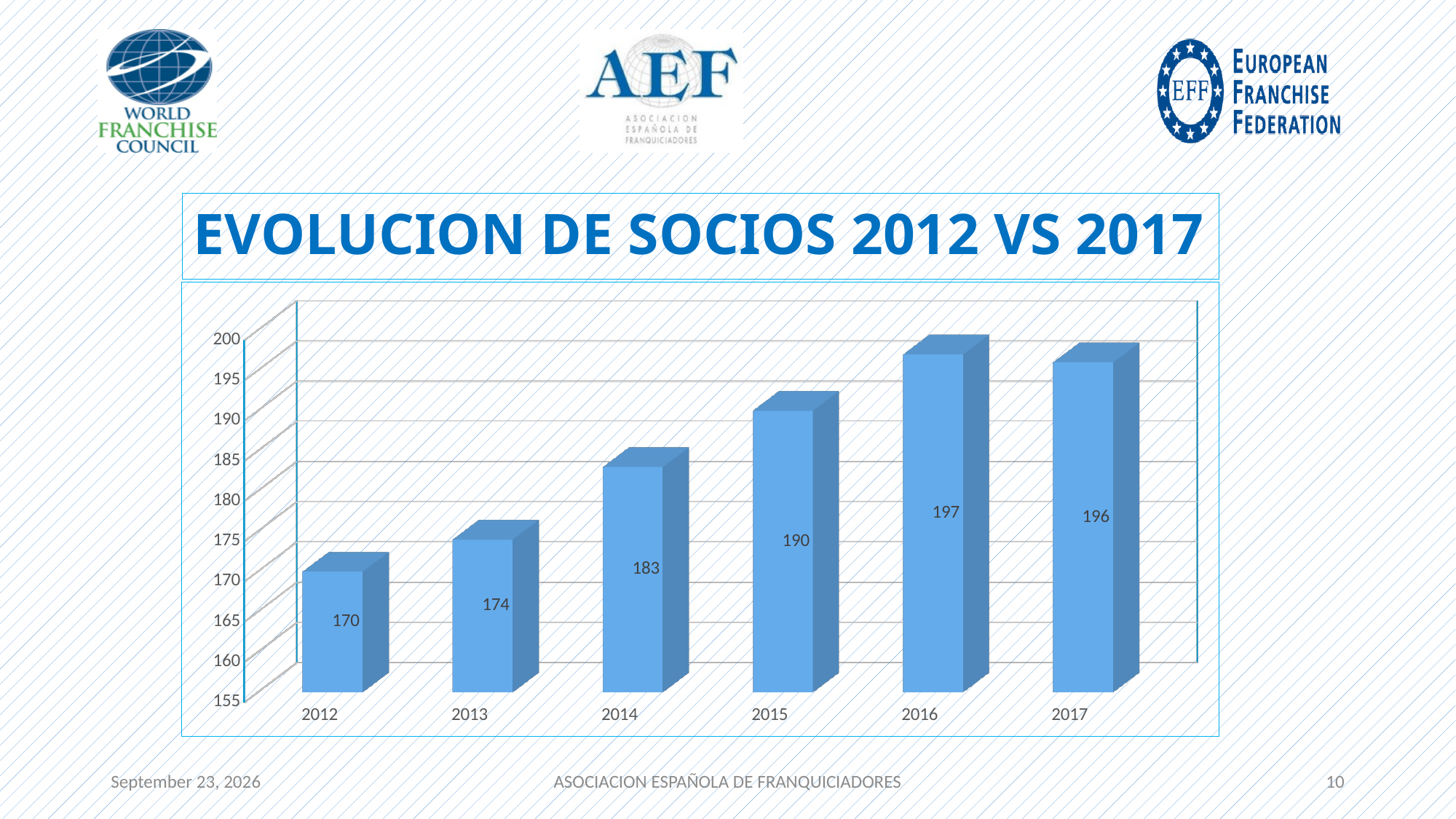
Which is larger, the value for 2014 or the value for 2015? 2015 Which year has the lowest value? 2012 What is the value for 2012? 170 What is the value for 2017? 196 What is the value for 2015? 190 What kind of chart is shown on the slide? bar chart Is the value for 2013 greater or less than 180? less What is the difference between the values for 2017 and 2012? 26 How many years are shown on the x axis? 6 What is the difference between the values for 2014 and 2013? 9 What is the title of the chart? EVOLUCION DE SOCIOS 2012 VS 2017 Which year has the highest value? 2016